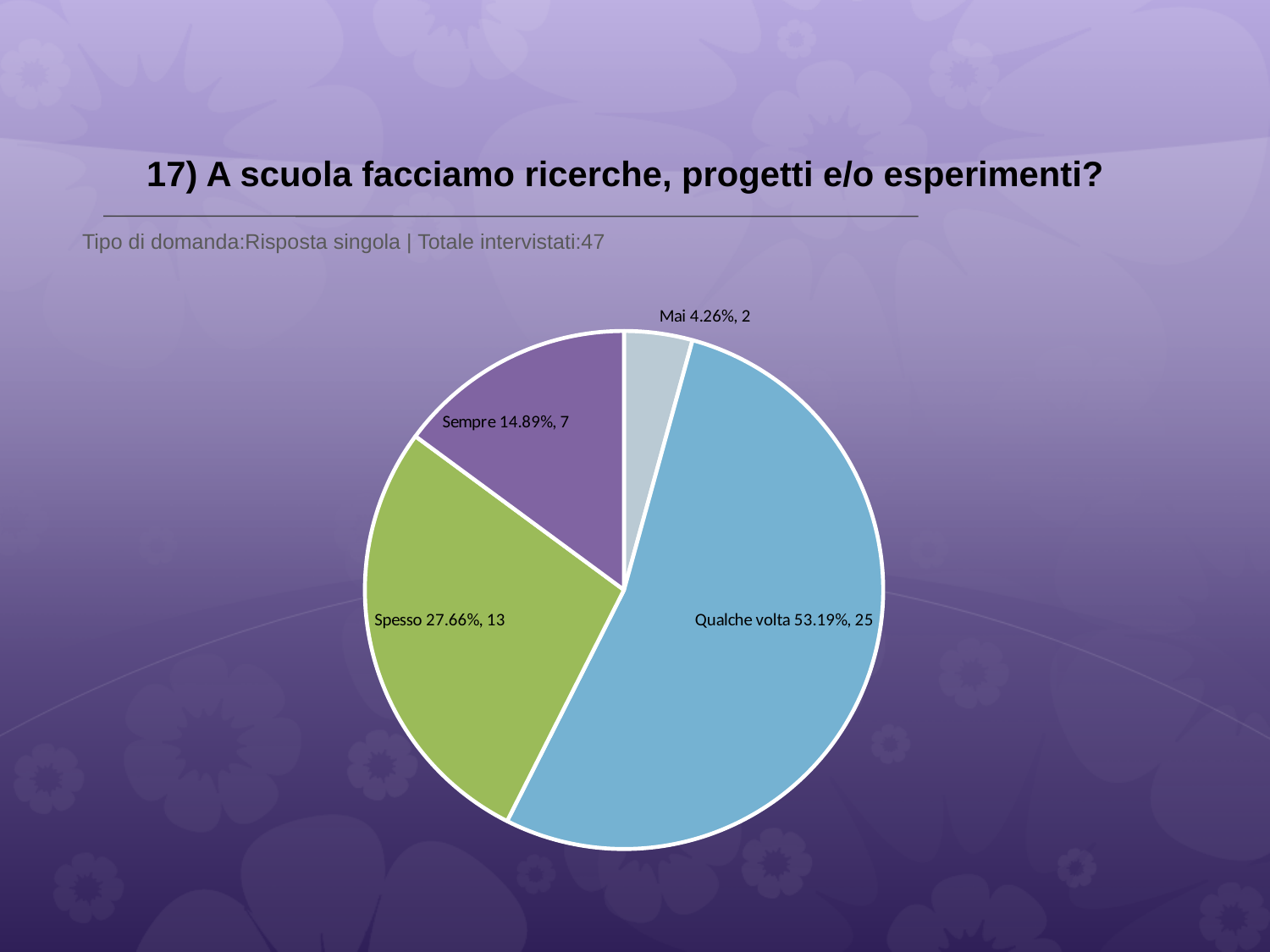
What is the difference in respondent count between 'Qualche volta' and 'Spesso'? 12 How many respondents answered 'Mai'? 2 Which has more respondents, 'Sempre' or 'Spesso'? Spesso What percentage is shown for the 'Qualche volta' slice? 53.19% What kind of chart is shown on the slide? pie chart Which category has the smallest slice? Mai Which category has the largest slice? Qualche volta What is the total number of respondents across all slices? 47 How many slices does the pie chart have? 4 What percentage is shown for the 'Sempre' slice? 14.89% What is the title of the chart's slide? 17) A scuola facciamo ricerche, progetti e/o esperimenti? How many respondents answered 'Spesso'? 13